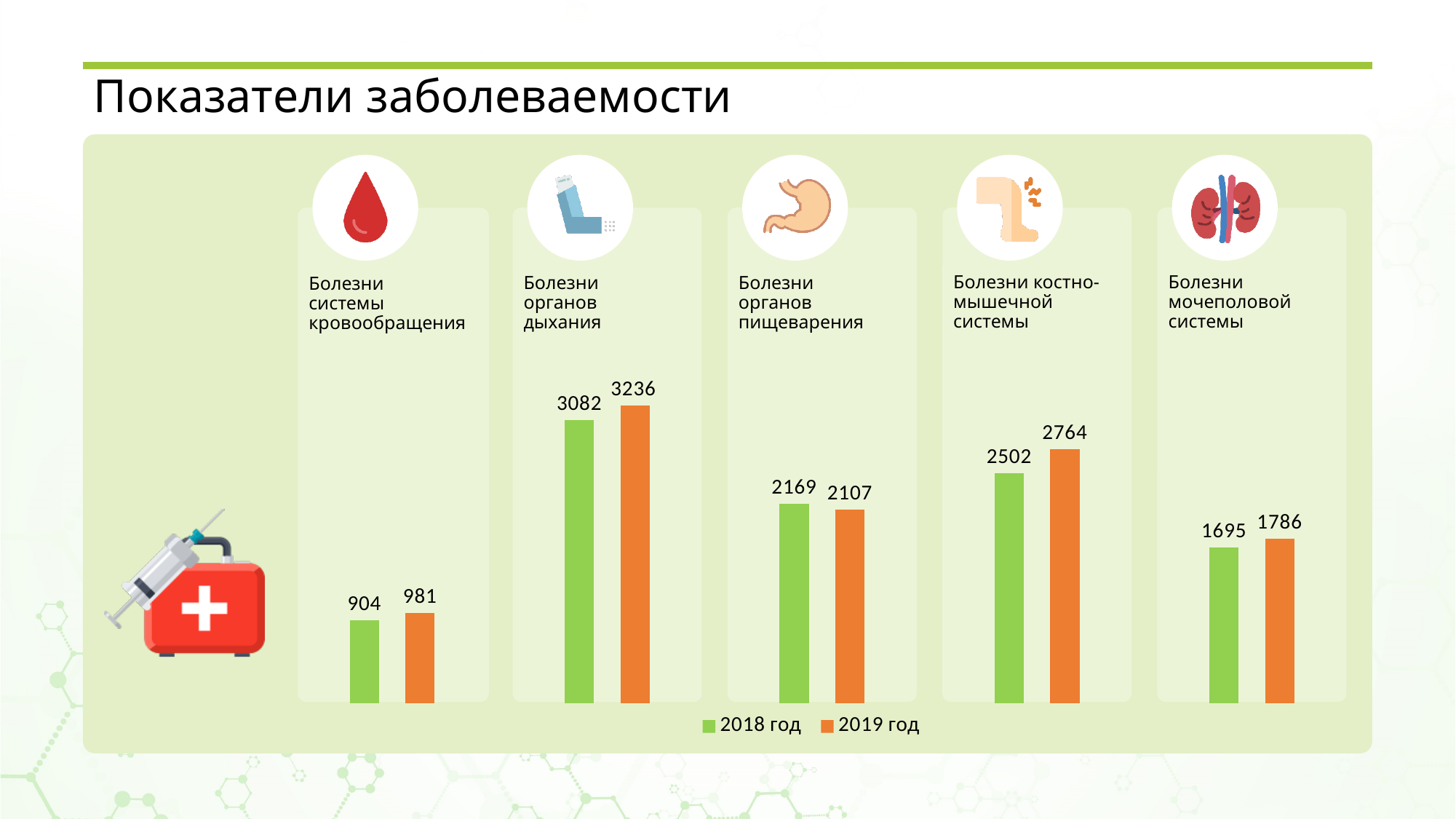
What is the value for 2018 год for Болезни органов дыхания? 3082 How many disease categories are shown in the chart? 5 What is the value for 2019 год for Болезни мочеполовой системы? 1786 What is the title of the slide? Показатели заболеваемости What is the difference between the 2018 год and 2019 год values for Болезни органов пищеварения? 62 What kind of chart is shown on the slide? Bar chart What is the difference between the 2019 год and 2018 год values for Болезни костно-мышечной системы? 262 Which category has the highest value for 2019 год? Болезни органов дыхания What is the value for 2019 год for Болезни системы кровообращения? 981 How many series does the legend list? 2 Which is larger for Болезни органов пищеварения: the 2018 год value or the 2019 год value? 2018 год Which category has the lowest value for 2018 год? Болезни системы кровообращения